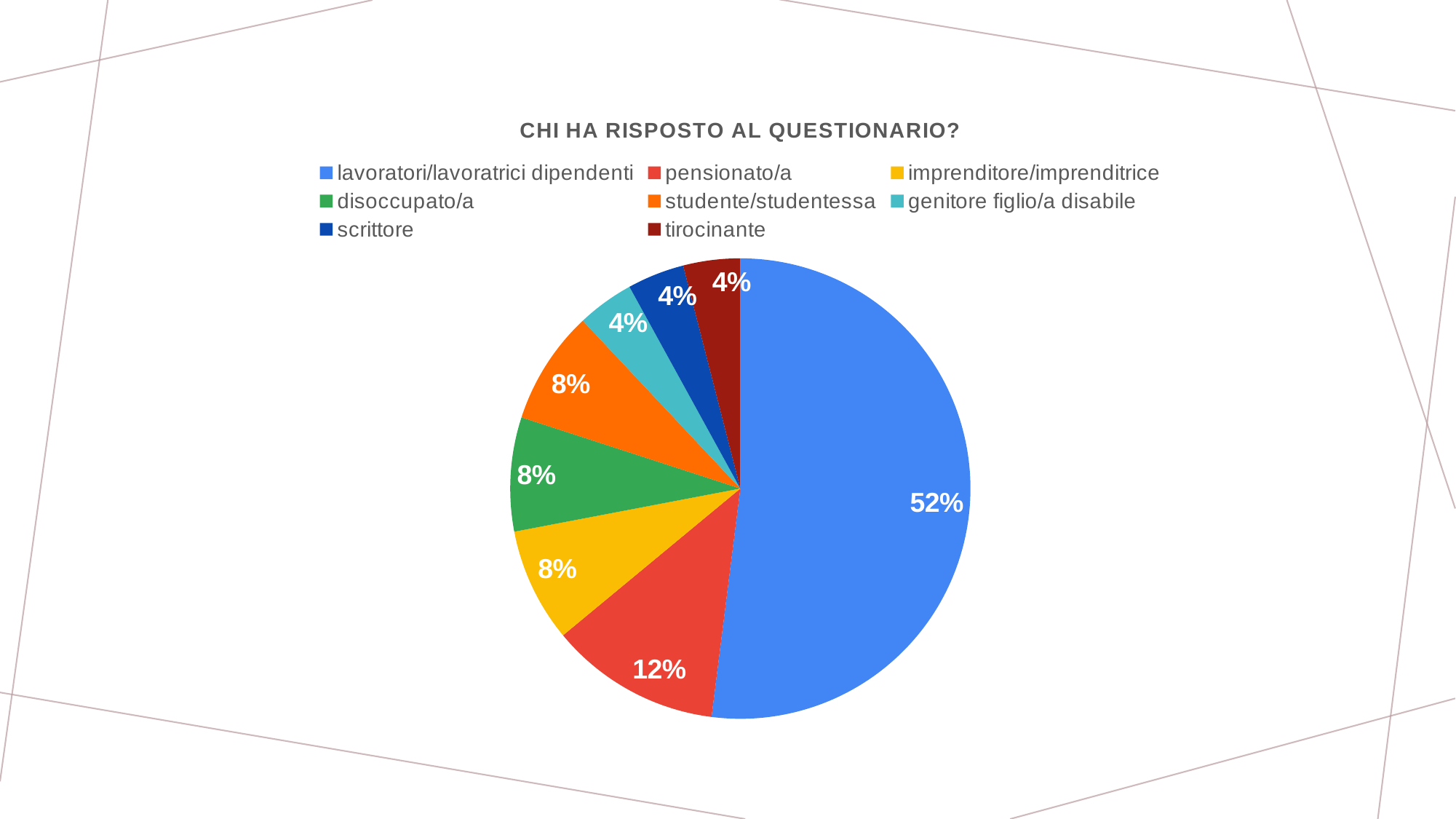
What type of chart is shown on the slide? pie chart How many categories does the legend list? 8 Which is larger, the slice for pensionato/a or the slice for disoccupato/a? pensionato/a What is the difference in percentage points between lavoratori/lavoratrici dipendenti and pensionato/a? 40 What is the combined percentage of scrittore and tirocinante? 8% Which colour represents genitore figlio/a disabile in the legend? teal (light blue) What percentage is shown for pensionato/a? 12% What percentage is shown for tirocinante? 4% What is the title of the chart? CHI HA RISPOSTO AL QUESTIONARIO? What percentage is shown for studente/studentessa? 8% What share of the pie is lavoratori/lavoratrici dipendenti? 52% Which category has the largest slice of the pie? lavoratori/lavoratrici dipendenti